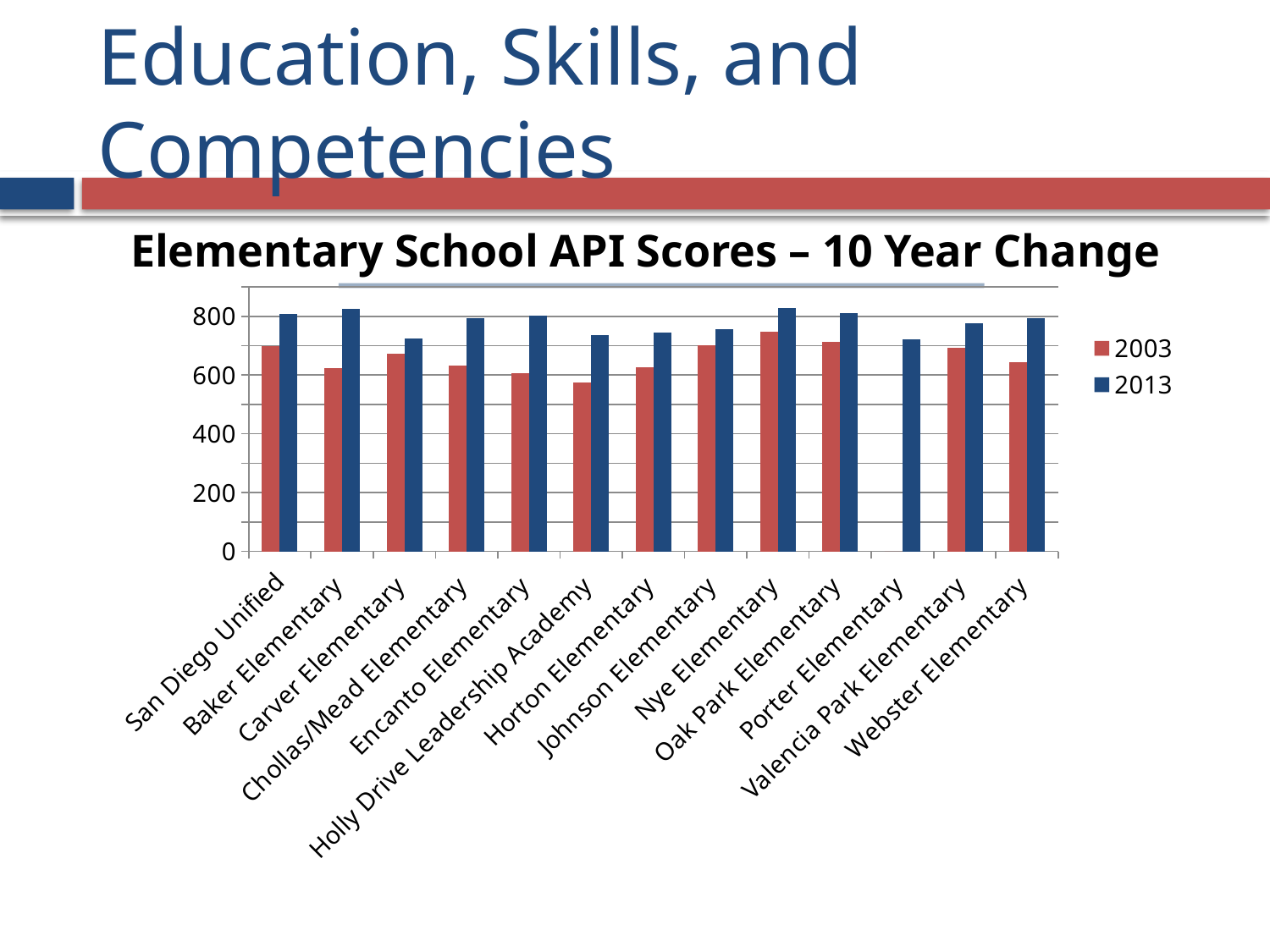
How many schools/categories are shown on the x axis? 13 Is the 2003 value for San Diego Unified greater or less than 600? greater What is the title of the chart? Elementary School API Scores – 10 Year Change Is the 2003 value for Holly Drive Leadership Academy greater or less than 600? less Is the 2013 value for Carver Elementary greater or less than 800? less What type of chart is shown on the slide? Bar chart Which has the larger 2003 value, Nye Elementary or Baker Elementary? Nye Elementary Which has the larger 2013 value, Carver Elementary or Chollas/Mead Elementary? Chollas/Mead Elementary Which year does the red series represent? 2003 How many series does the legend list? 2